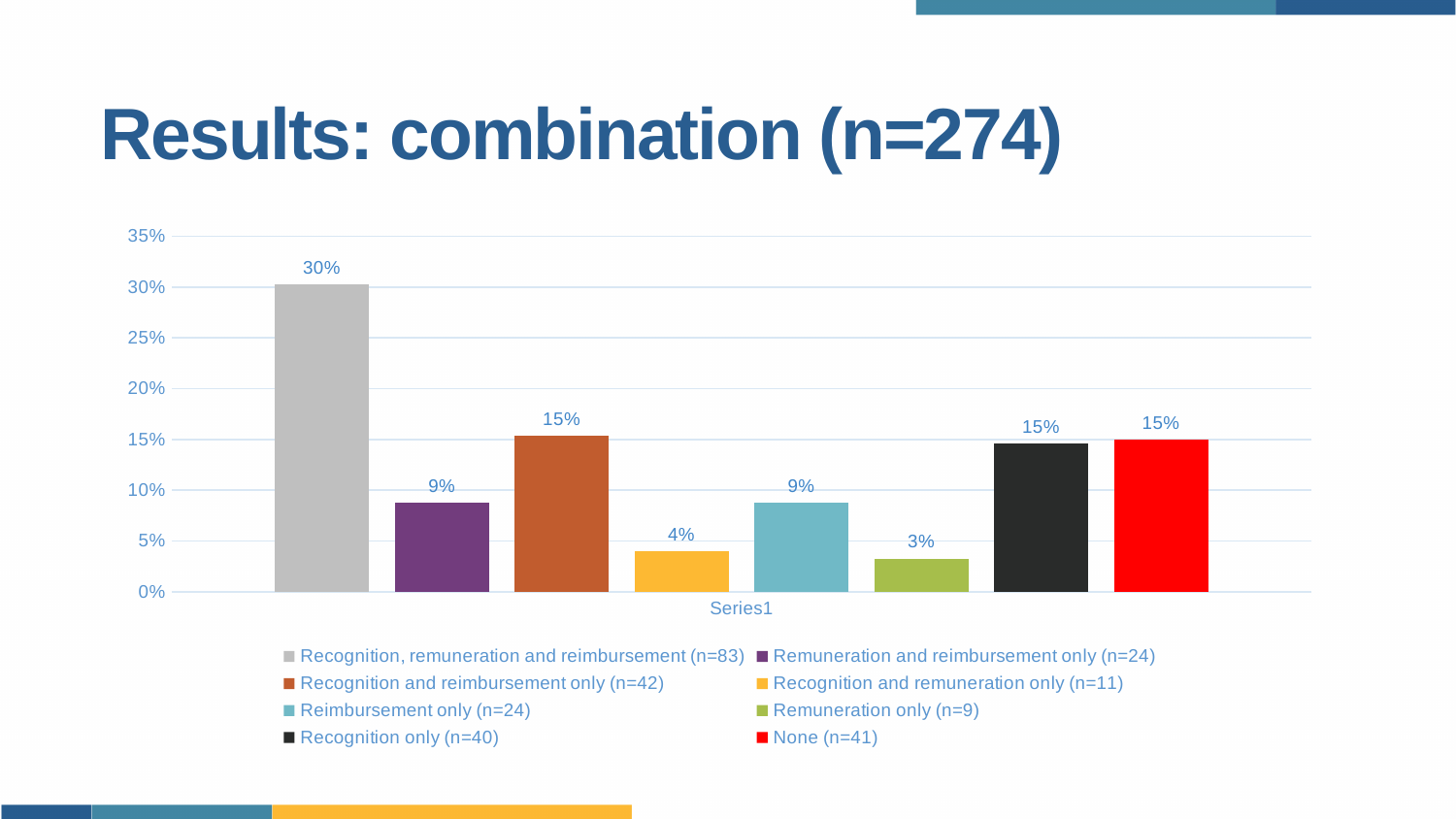
Which is larger, the value for "Remuneration and reimbursement only (n=24)" or the value for "Remuneration only (n=9)"? Remuneration and reimbursement only (n=24) Which category has the lowest value? Remuneration only (n=9) What is the difference between the value for "Recognition, remuneration and reimbursement (n=83)" and the value for "Recognition only (n=40)"? 15% What is the value for "None (n=41)"? 15% How many bars are plotted in the chart? 8 What is the value for "Recognition and remuneration only (n=11)"? 4% How many entries does the legend list? 8 What is the value for "Reimbursement only (n=24)"? 9% What is the title of the slide? Results: combination (n=274) Which category has the highest value? Recognition, remuneration and reimbursement (n=83) What is the value for "Recognition, remuneration and reimbursement (n=83)"? 30% What type of chart is shown on the slide? bar chart